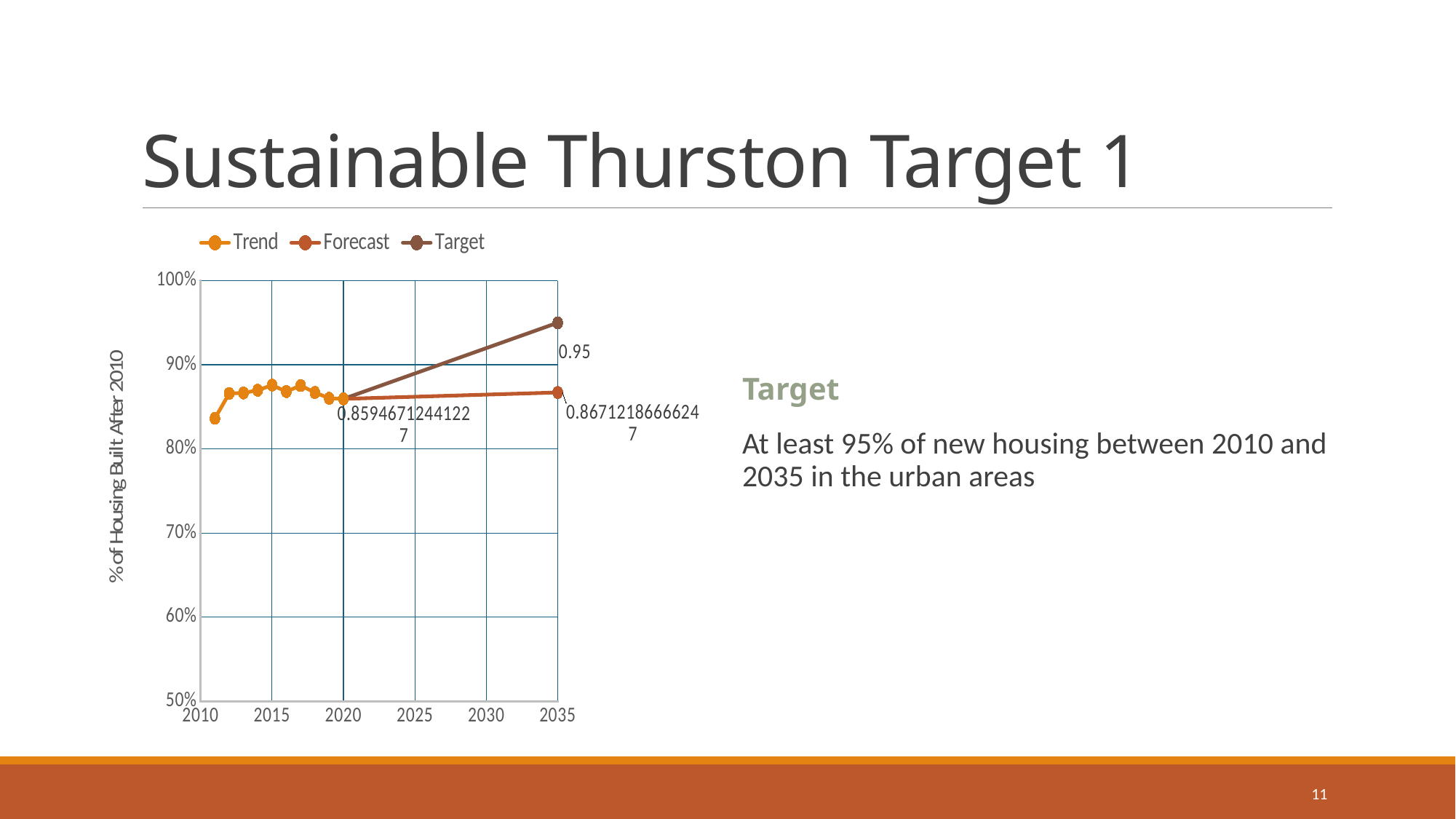
What is the label on the vertical axis? % of Housing Built After 2010 What are the names of the series in the legend? Trend, Forecast, Target Is the Target value at 2035 greater or less than 90%? greater What is the data label shown at the 2020 point where the Forecast line begins? 0.85946712441227 What is the data label shown for the Target series at 2035? 0.95 Is the Forecast value at 2035 greater or less than 90%? less Is the Trend value at 2011 greater or less than 80%? greater What is the data label shown for the Forecast series at 2035? 0.86712186666247 At 2035, which series has the higher value, Target or Forecast? Target Does the Target line rise or fall between 2020 and 2035? rise How many series does the legend list? 3 What kind of chart is shown on the slide? line chart